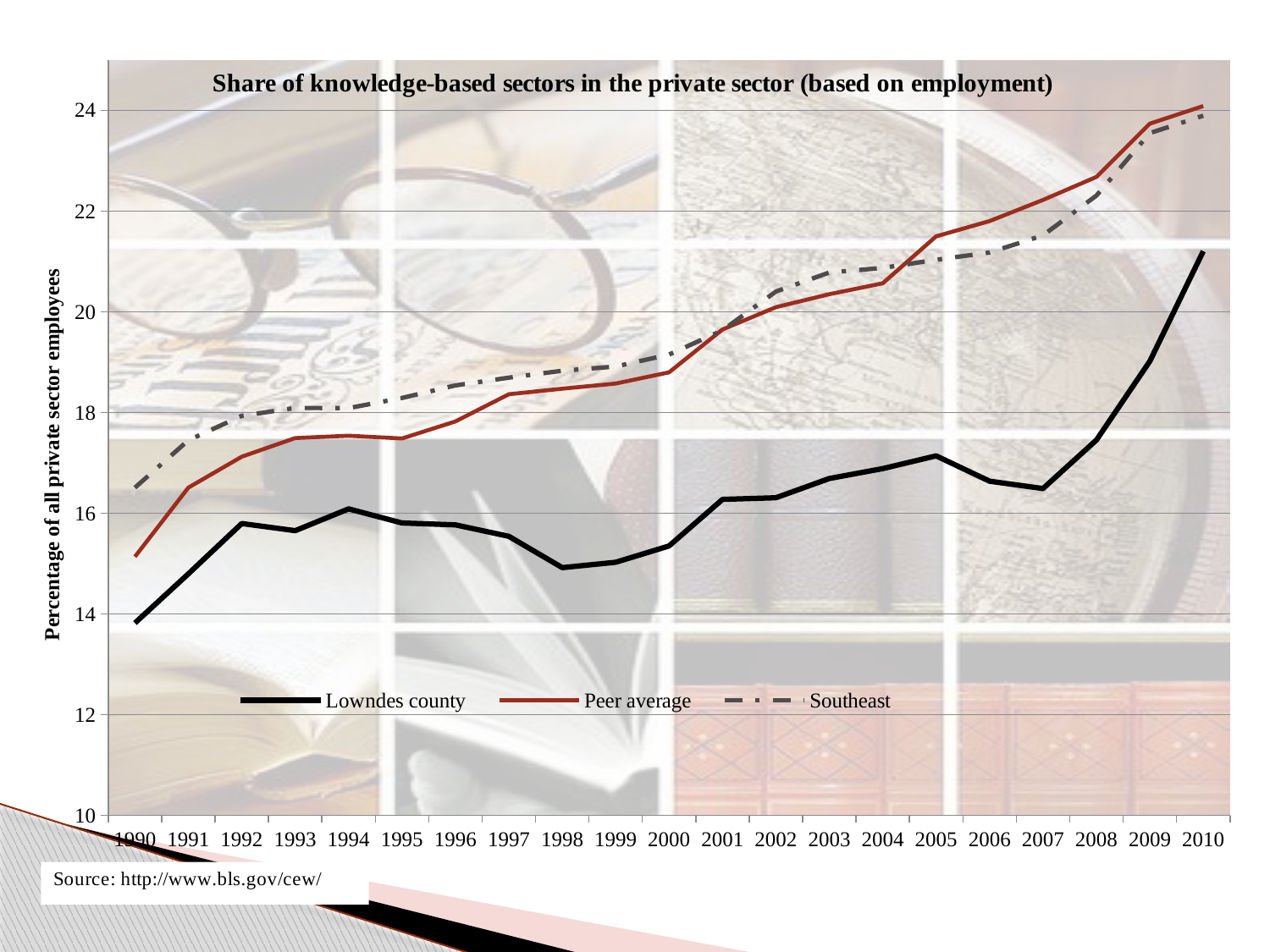
Is the Peer average value in 2005 greater or less than 20? greater How many series does the legend list? 3 Which series has the lowest value in 2005? Lowndes county In 2000, which is larger: the Peer average value or the Lowndes county value? Peer average In which year is the Lowndes county value highest? 2010 What kind of chart is shown on the slide? line chart What is the title of the chart? Share of knowledge-based sectors in the private sector (based on employment) Does the Peer average series rise or fall from 1990 to 2010? rise How many years are plotted along the x axis? 21 Is the Lowndes county value in 1990 greater or less than 14? less Which series is drawn with a dash-dot line? Southeast In which year is the Lowndes county value lowest? 1990